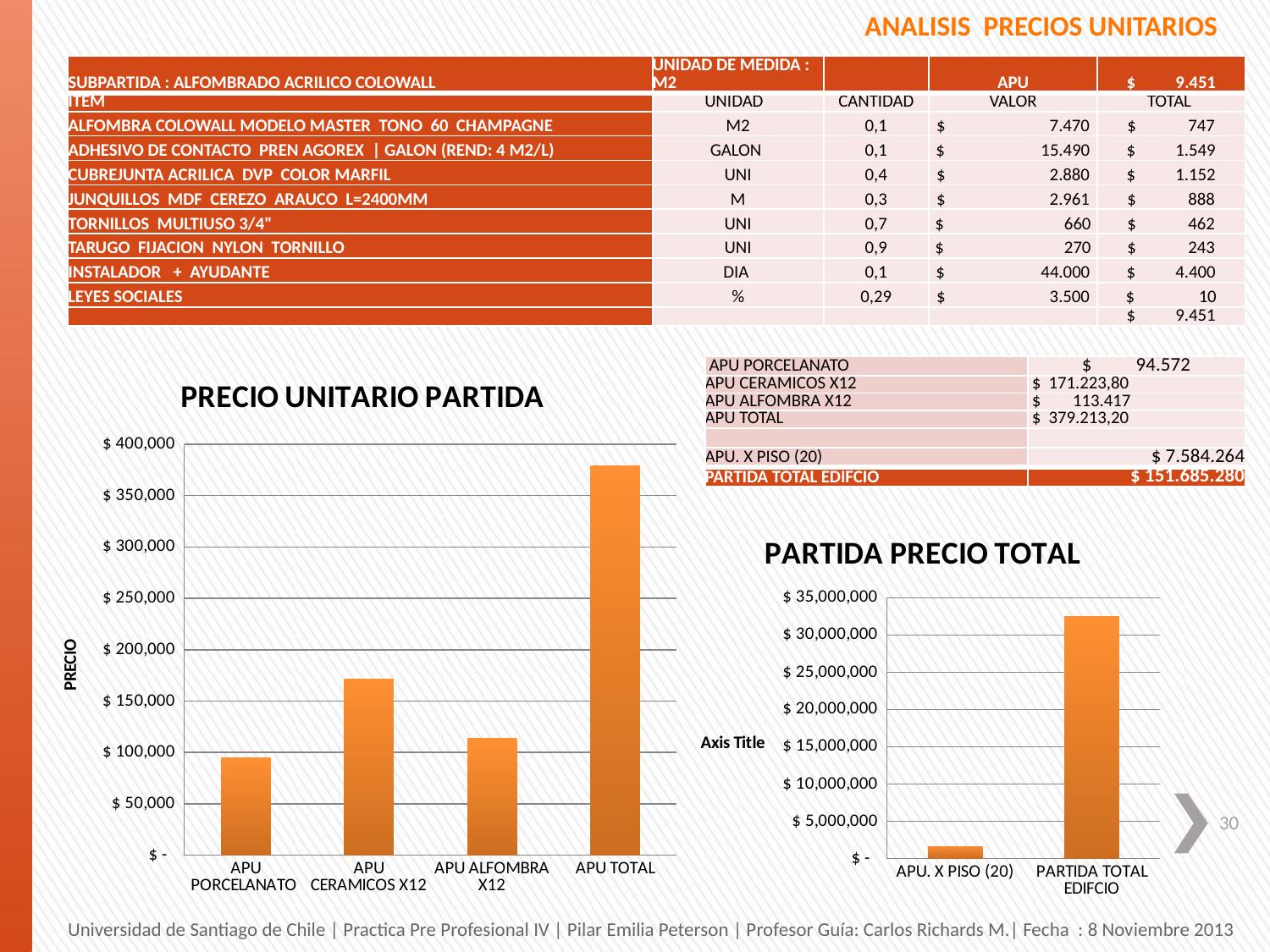
In the chart titled "PRECIO UNITARIO PARTIDA", how many categories are plotted? 4 In the chart titled "PARTIDA PRECIO TOTAL", how many categories are plotted? 2 In the chart titled "PRECIO UNITARIO PARTIDA", which category has the lowest value? APU PORCELANATO In the chart titled "PRECIO UNITARIO PARTIDA", is the value for APU CERAMICOS X12 greater or less than $ 150,000? greater In the chart titled "PRECIO UNITARIO PARTIDA", is the value for APU TOTAL greater or less than $ 350,000? greater In the chart titled "PRECIO UNITARIO PARTIDA", is the value for APU PORCELANATO greater or less than $ 100,000? less In the chart titled "PRECIO UNITARIO PARTIDA", what kind of chart is shown? bar chart In the chart titled "PRECIO UNITARIO PARTIDA", what is the label on the vertical axis? PRECIO In the chart titled "PRECIO UNITARIO PARTIDA", which is larger, APU CERAMICOS X12 or APU ALFOMBRA X12? APU CERAMICOS X12 In the chart titled "PARTIDA PRECIO TOTAL", which category has the highest value? PARTIDA TOTAL EDIFCIO In the chart titled "PRECIO UNITARIO PARTIDA", which category has the highest value? APU TOTAL